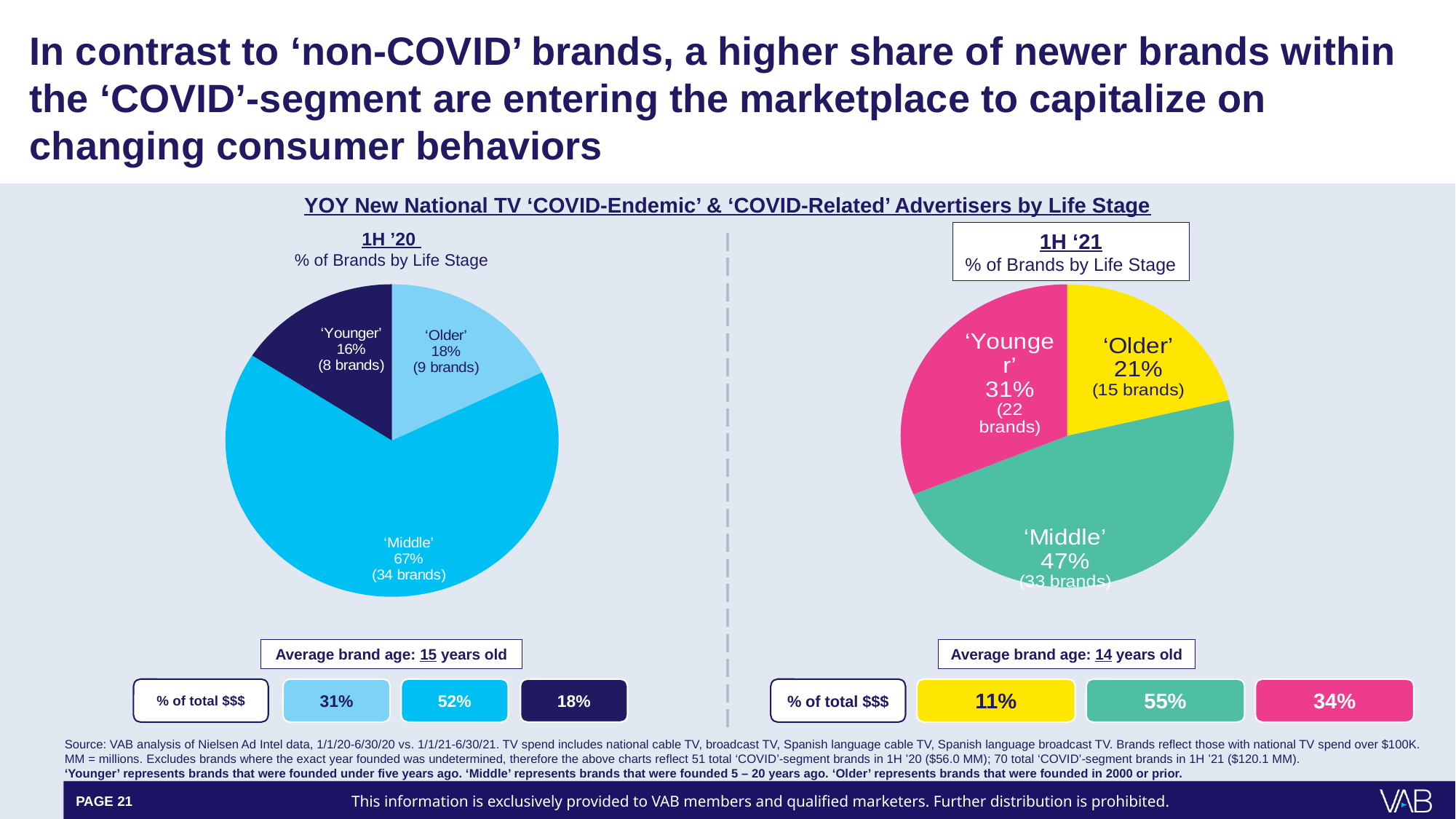
What type of chart is used to show % of Brands by Life Stage for 1H '20? Pie chart In the 1H '20 pie chart, which is larger: the 'Older' share or the 'Younger' share? 'Older' In the 1H '20 pie chart, which life stage has the smallest share? 'Younger' In the 1H '21 pie chart, which life stage has the largest share? 'Middle' What is the difference in the number of 'Middle' brands between 1H '20 and 1H '21? 1 brand In the 1H '21 pie chart, what share of brands is 'Older'? 21% In the 1H '20 pie chart, how many brands are in the 'Older' slice? 9 brands What colour is the 'Middle' slice in the 1H '21 pie chart? Teal/green How many slices does the 1H '21 pie chart have? 3 What is the difference in percentage points between the 'Younger' share in 1H '21 and the 'Younger' share in 1H '20? 15 percentage points In the 1H '20 pie chart, what share of brands is 'Middle'? 67% In the 1H '21 pie chart, how many brands are in the 'Younger' slice? 22 brands